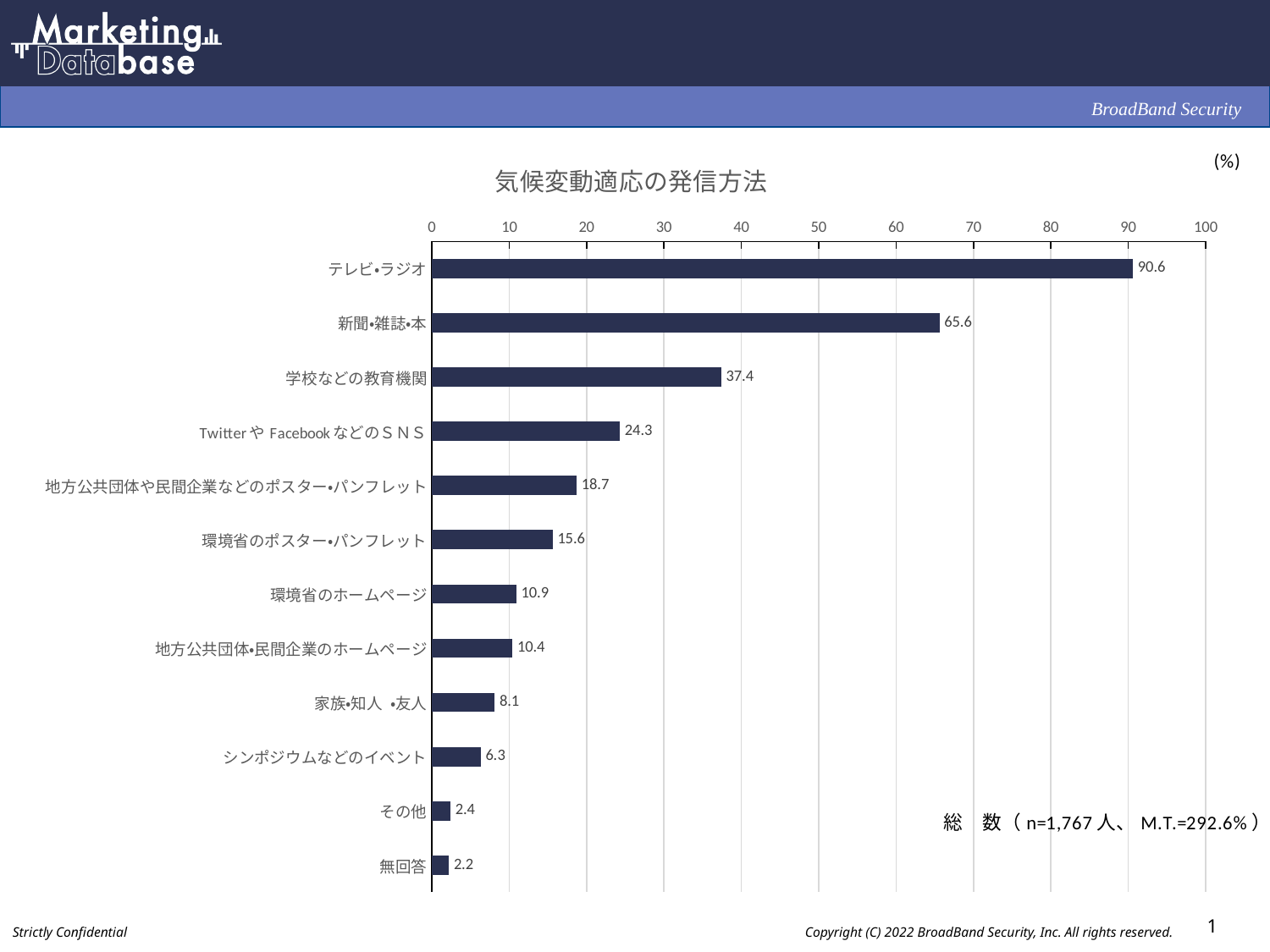
Which category has the highest value? テレビ・ラジオ What is the title of the chart? 気候変動適応の発信方法 Is the value for 新聞・雑誌・本 greater or less than 60? greater What is the difference between the values for Twitter や Facebook などのSNS and 地方公共団体や民間企業などのポスター・パンフレット? 5.6 Which is larger, the value for 家族・知人・友人 or the value for シンポジウムなどのイベント? 家族・知人・友人 Which category has the lowest value? 無回答 What is the value for 学校などの教育機関? 37.4 What is the value for テレビ・ラジオ? 90.6 What is the value for 環境省のホームページ? 10.9 What kind of chart is shown on the slide? bar chart How many categories are shown in the chart? 12 What is the difference between the values for テレビ・ラジオ and 新聞・雑誌・本? 25.0